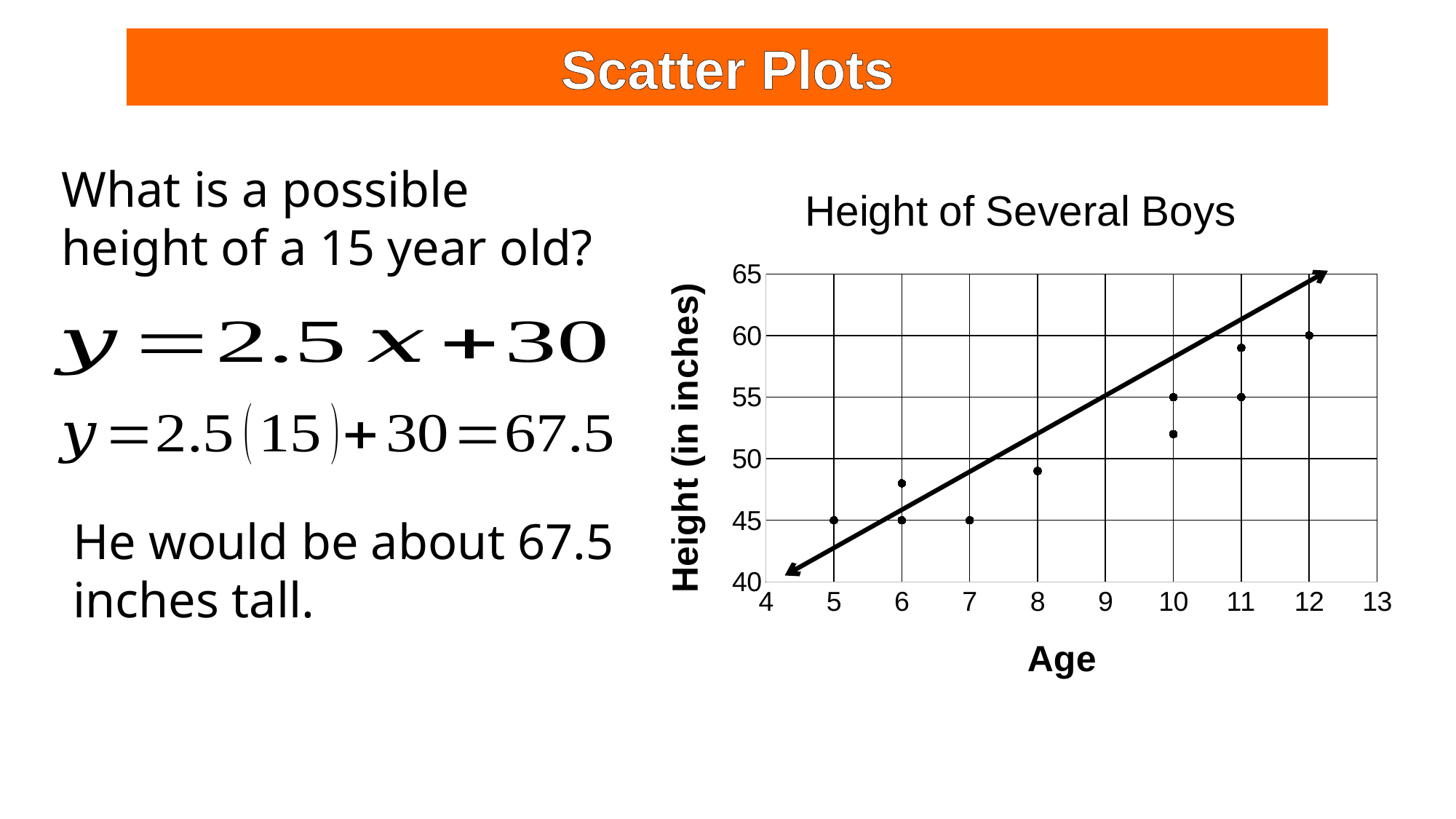
What kind of chart is shown on the slide? scatter plot What is the difference between the height plotted at age 12 and the height plotted at age 5? 15 Do the plotted heights generally rise or fall as age increases? rise What is the height plotted for the boy aged 5? 45 What is the label of the y axis of the chart? Height (in inches) Is the height plotted at age 8 greater or less than 45? greater What is the title of the chart? Height of Several Boys How many data points are plotted on the chart? 10 What is the height plotted for the boy aged 12? 60 Is the lower of the two points at age 10 greater or less than 50? greater Is the height plotted at age 8 greater or less than 50? less What is the height plotted for the boy aged 7? 45